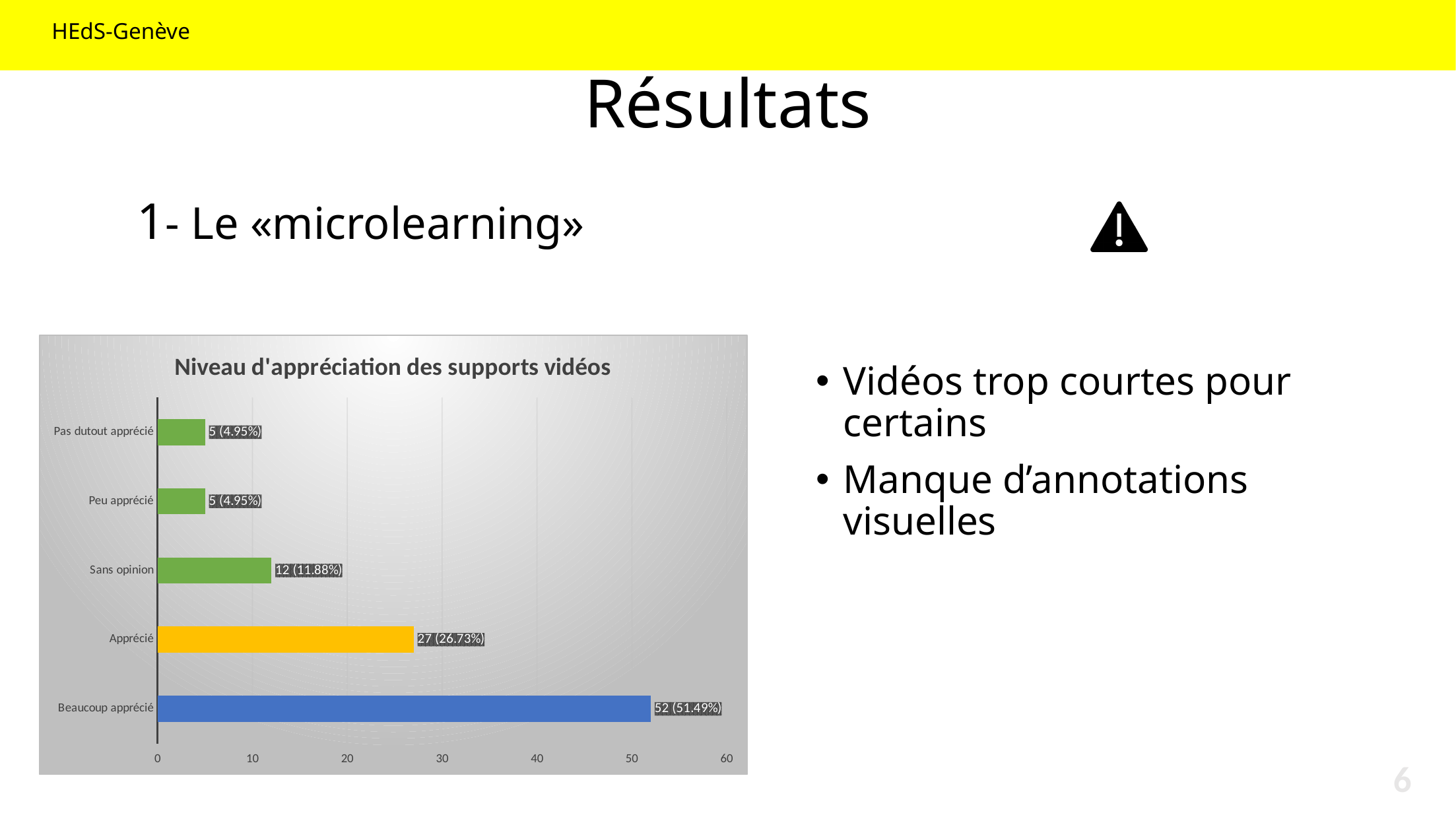
Is the value for "Beaucoup apprécié" greater or less than 50? greater What is the title of the chart? Niveau d'appréciation des supports vidéos How many categories are shown in the chart? 5 Which category has the highest value? Beaucoup apprécié Which is larger, the value for "Sans opinion" or the value for "Peu apprécié"? Sans opinion What is the data label for "Beaucoup apprécié"? 52 (51.49%) What is the difference in count between "Beaucoup apprécié" and "Apprécié"? 25 What is the data label for "Apprécié"? 27 (26.73%) What kind of chart is shown on the slide? Bar chart What is the difference in count between "Apprécié" and "Sans opinion"? 15 What is the data label for "Sans opinion"? 12 (11.88%) What is the data label for "Peu apprécié"? 5 (4.95%)